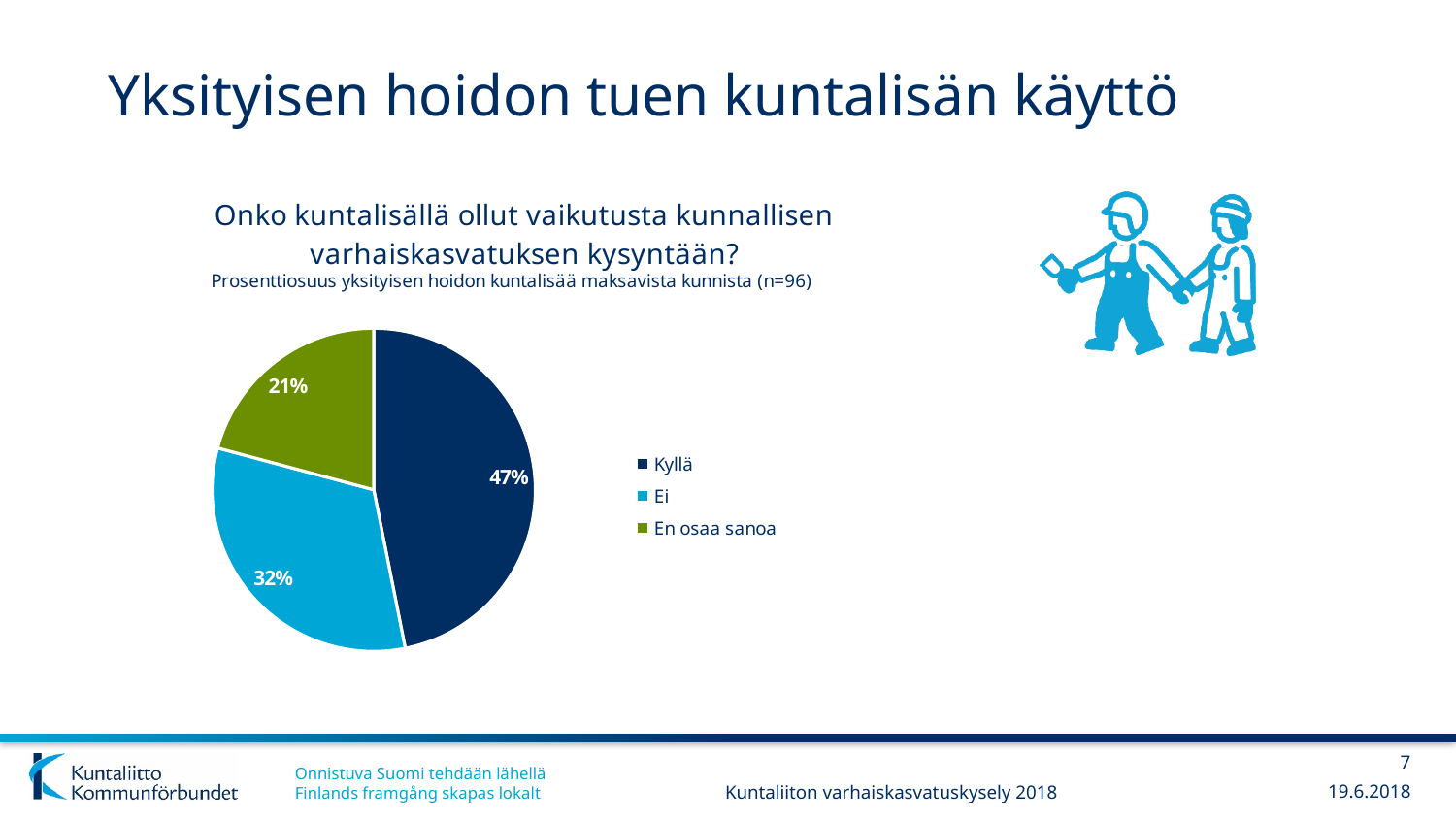
Which category has the smallest share of the pie? En osaa sanoa What percentage of the pie is labelled for "Kyllä"? 47% What is the sample size (n) stated in the chart subtitle? n=96 What is the difference in percentage points between the "Kyllä" and "Ei" slices? 15 Which slice is larger, "Ei" or "En osaa sanoa"? Ei What kind of chart is shown on the slide? Pie chart What percentage of the pie is labelled for "En osaa sanoa"? 21% How many slices does the pie chart have? 3 What percentage of the pie is labelled for "Ei"? 32% Which category has the largest share of the pie? Kyllä How many entries does the legend list? 3 What colour is the "Kyllä" slice in the pie chart? Dark blue